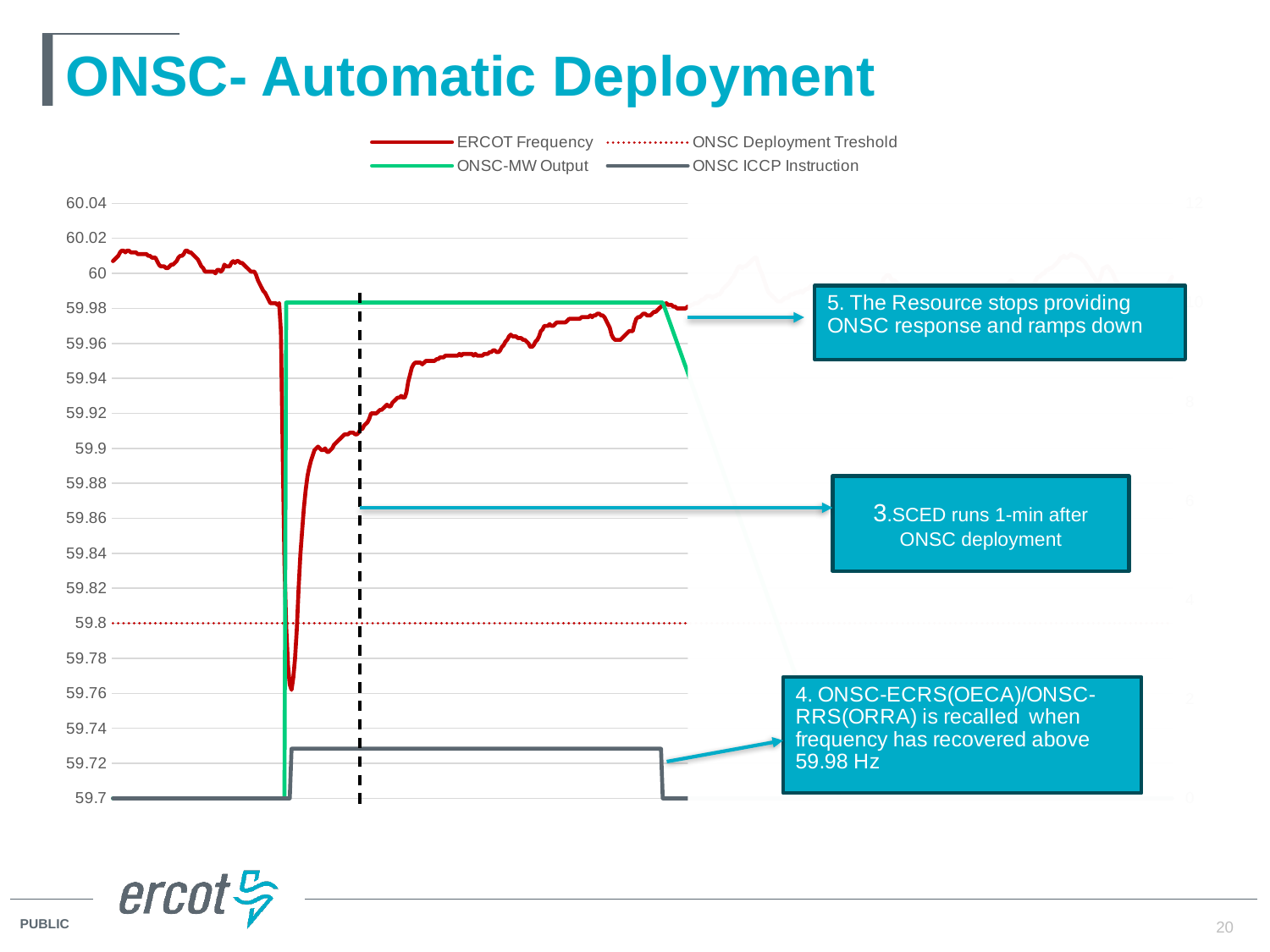
What is the lowest value shown on the y axis? 59.7 Is the lowest point of the ERCOT Frequency line greater or less than 59.78? less Which series in the legend is drawn as a dotted line? ONSC Deployment Treshold What colour is the ONSC-MW Output line? green At what frequency value is the ONSC Deployment Threshold line drawn? 59.8 Is the flat level of the ONSC-MW Output line greater or less than 59.96? greater Is the ERCOT Frequency value at the start of the chart greater or less than 60? greater After its sharp dip, does the ERCOT Frequency line rise or fall as it moves to the right? rise What is the highest value shown on the y axis? 60.04 What kind of chart is shown on the slide? line chart How many series does the chart legend list? 4